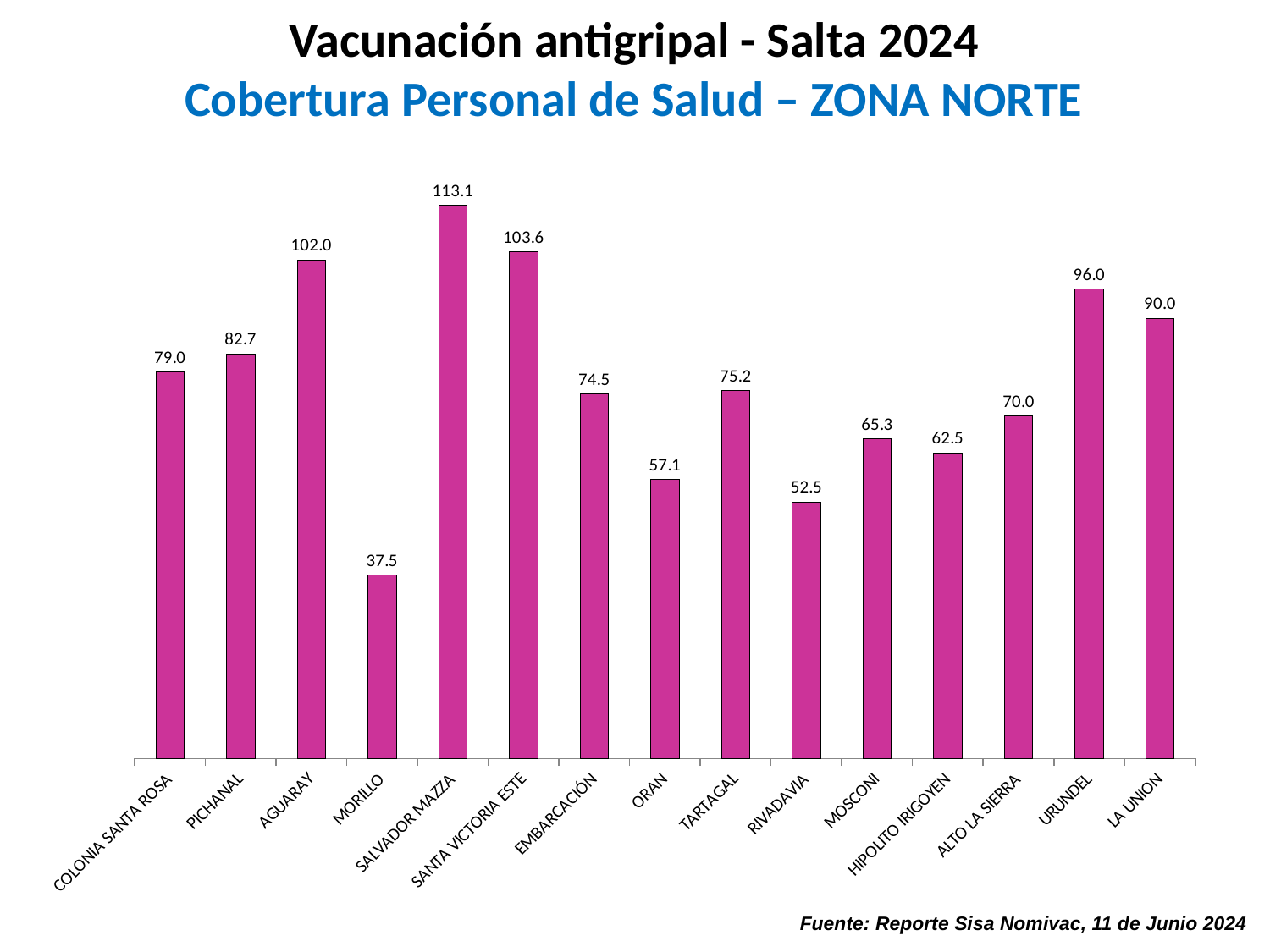
How many categories are shown on the x axis? 15 What is the subtitle of the chart shown in blue? Cobertura Personal de Salud – ZONA NORTE What is the value for MORILLO? 37.5 Which category has the lowest value? MORILLO What kind of chart is shown on the slide? Bar chart Which category has the highest value? SALVADOR MAZZA What is the difference between the values for SANTA VICTORIA ESTE and AGUARAY? 1.6 What is the value for HIPOLITO IRIGOYEN? 62.5 What is the difference between the values for URUNDEL and LA UNION? 6.0 What is the value for SALVADOR MAZZA? 113.1 Which is larger, the value for PICHANAL or the value for COLONIA SANTA ROSA? PICHANAL Which is larger, the value for ORAN or the value for RIVADAVIA? ORAN